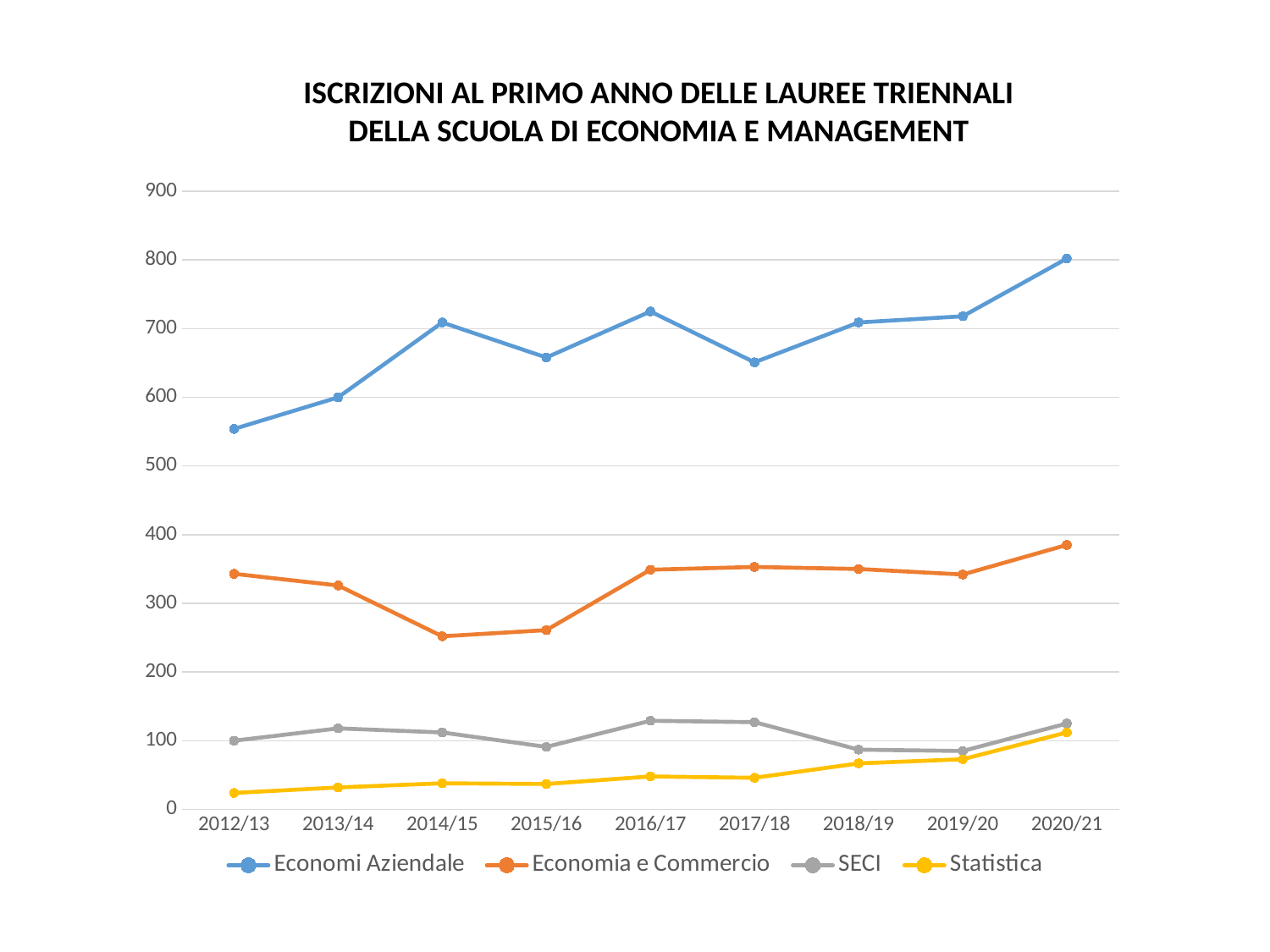
In which academic year is the value for Economia e Commercio lowest? 2014/15 Is the value for Economi Aziendale in 2012/13 greater or less than 500? greater In which academic year is the value for Statistica highest? 2020/21 What kind of chart is shown on the slide? line chart Does the value for Statistica generally rise or fall from 2012/13 to 2020/21? rise In which academic year is the value for Economi Aziendale lowest? 2012/13 How many academic years are shown on the x axis? 9 Which series has the larger value in 2012/13, SECI or Statistica? SECI Is the value for Economia e Commercio in 2014/15 greater or less than 300? less How many series does the legend list? 4 Is the value for Statistica in 2020/21 greater or less than 100? greater In which academic year is the value for Economi Aziendale highest? 2020/21